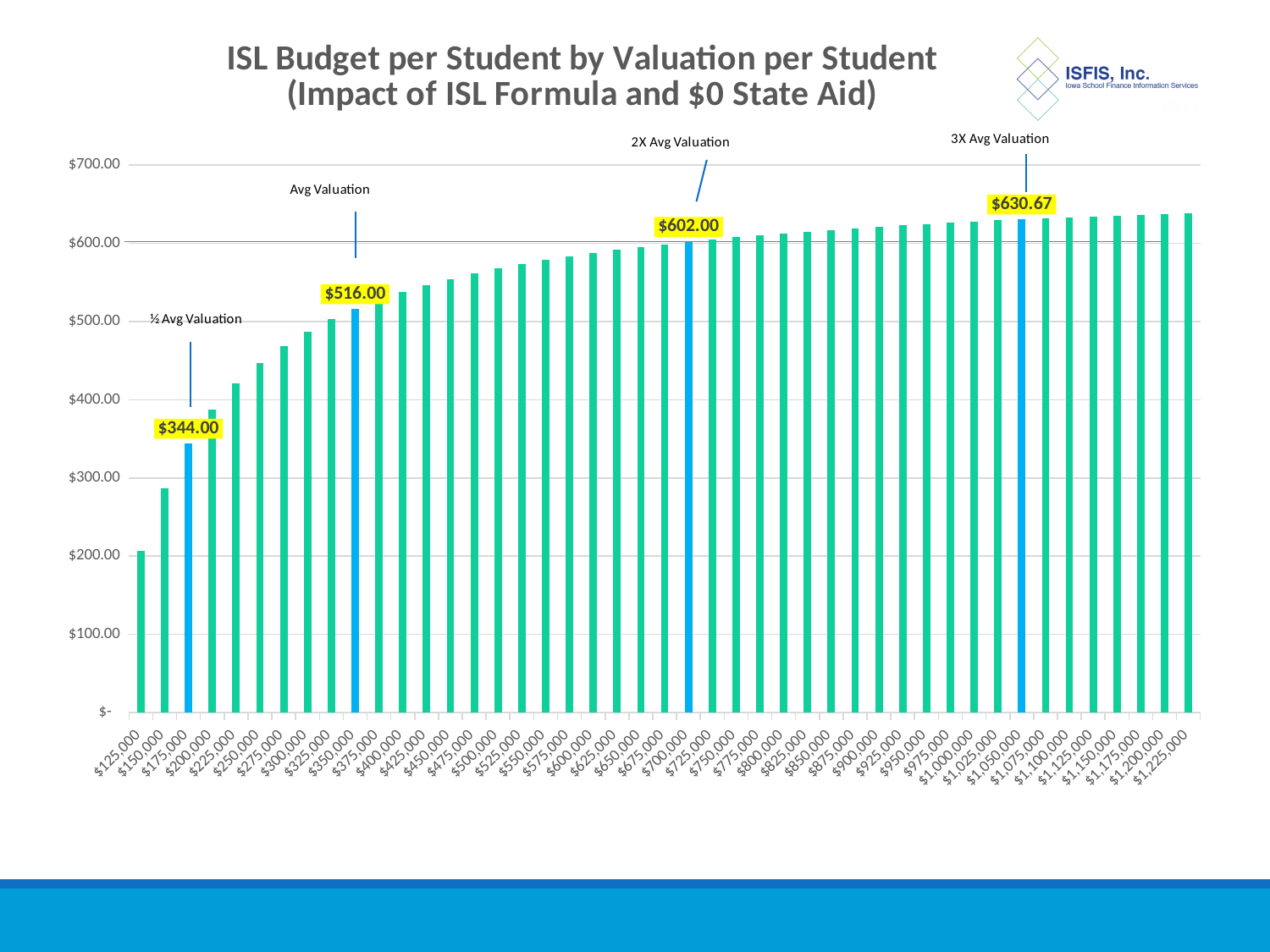
What kind of chart is shown on the slide? bar chart Is the ISL budget per student at a valuation of $125,000 greater or less than $300.00? less What is the difference between the ISL budget per student at $350,000 valuation and at $175,000 valuation? $172.00 What is the ISL budget per student at a valuation per student of $350,000? $516.00 Is the ISL budget per student at a valuation of $1,225,000 greater or less than $600.00? greater What is the ISL budget per student at a valuation per student of $1,050,000? $630.67 What is the ISL budget per student at a valuation per student of $700,000? $602.00 Which valuation per student has the lowest ISL budget per student? $125,000 Do the ISL budget per student values rise or fall as valuation per student increases along the x axis? rise Which valuation per student has the higher ISL budget per student, $350,000 or $700,000? $700,000 What is the difference between the ISL budget per student at $1,050,000 valuation and at $700,000 valuation? $28.67 What is the ISL budget per student at a valuation per student of $175,000? $344.00